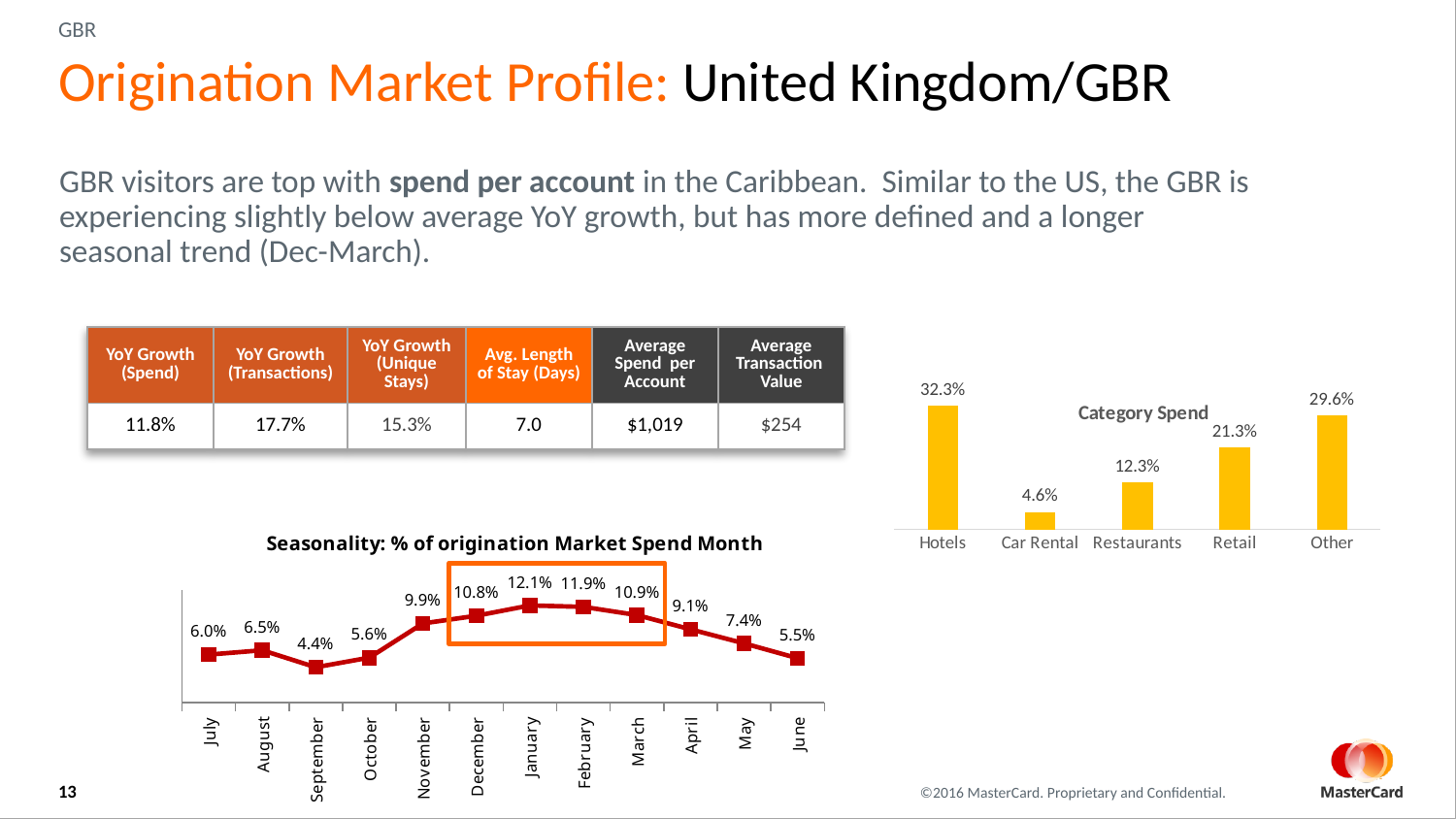
What kind of chart is the Seasonality chart? Line chart In the Category Spend chart, what is the difference between Retail and Restaurants? 9.0% In the Seasonality chart, what is the difference between the values for December and June? 5.3% In the Category Spend chart, what is the value for Hotels? 32.3% In the Category Spend chart, which category has the highest value? Hotels In the Seasonality chart, which month has the highest value? January In the Category Spend chart, how many categories are shown? 5 In the Seasonality chart, which is larger, the value for November or the value for April? November In the Seasonality chart, what is the value for January? 12.1% In the Category Spend chart, which category has the lowest value? Car Rental What kind of chart is the Category Spend chart? Bar chart In the Seasonality chart, which month has the lowest value? September